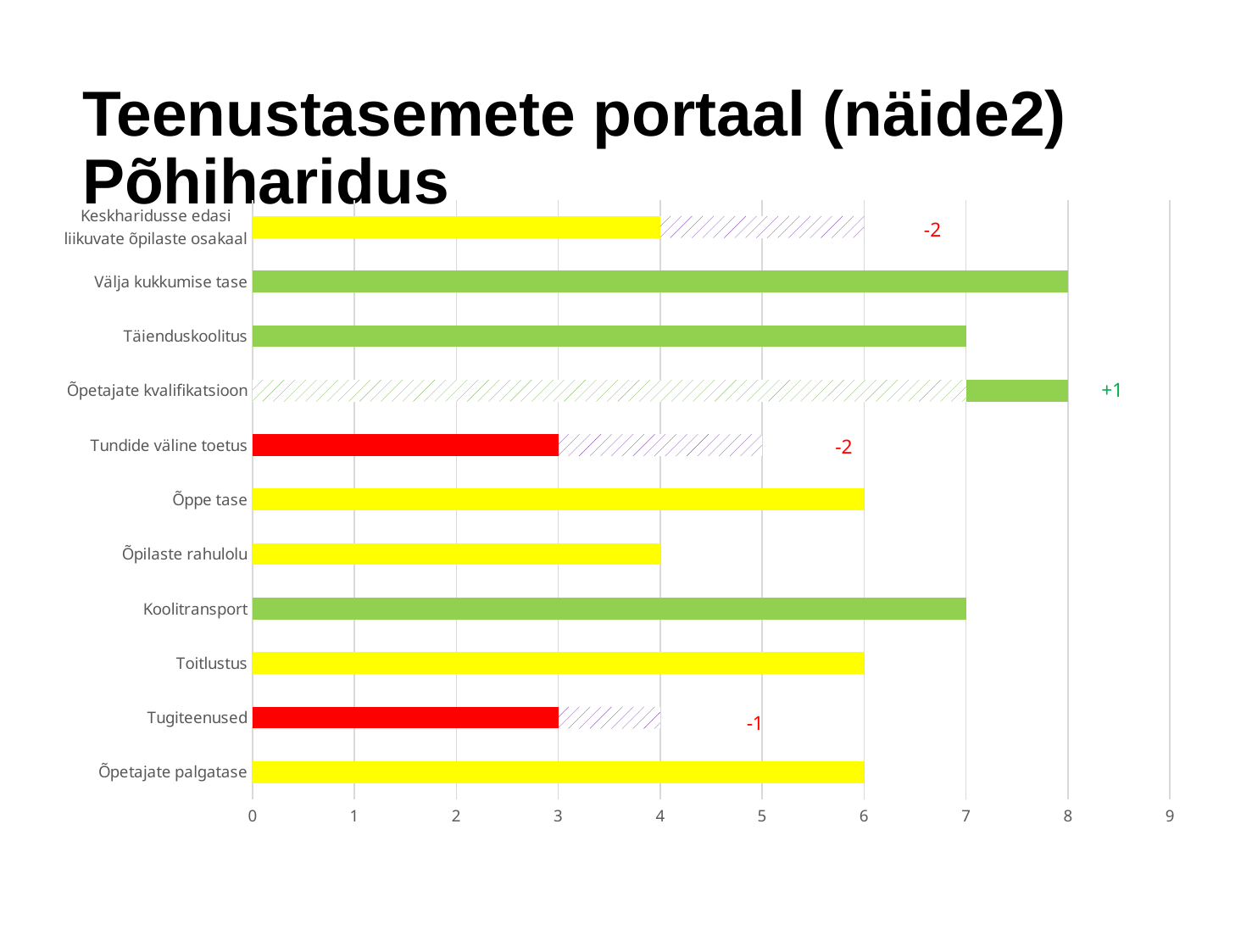
What value does the bar for Välja kukkumise tase reach on the axis? 8 What is the difference between the bar values for Täienduskoolitus and Õppe tase? 1 What kind of chart is shown on the slide? bar chart What value does the bar for Koolitransport reach on the axis? 7 Which category has the longest solid bar in the chart? Välja kukkumise tase What change label is printed next to the Tundide väline toetus bar? -2 Which is larger, the bar for Toitlustus or the bar for Õpilaste rahulolu? Toitlustus Is the value for Õpetajate palgatase greater or less than 5? greater How many categories are listed on the vertical axis of the chart? 11 What value does the bar for Õpilaste rahulolu reach on the axis? 4 What change label is printed next to the Õpetajate kvalifikatsioon bar? +1 What value does the solid red bar for Tugiteenused reach on the axis? 3